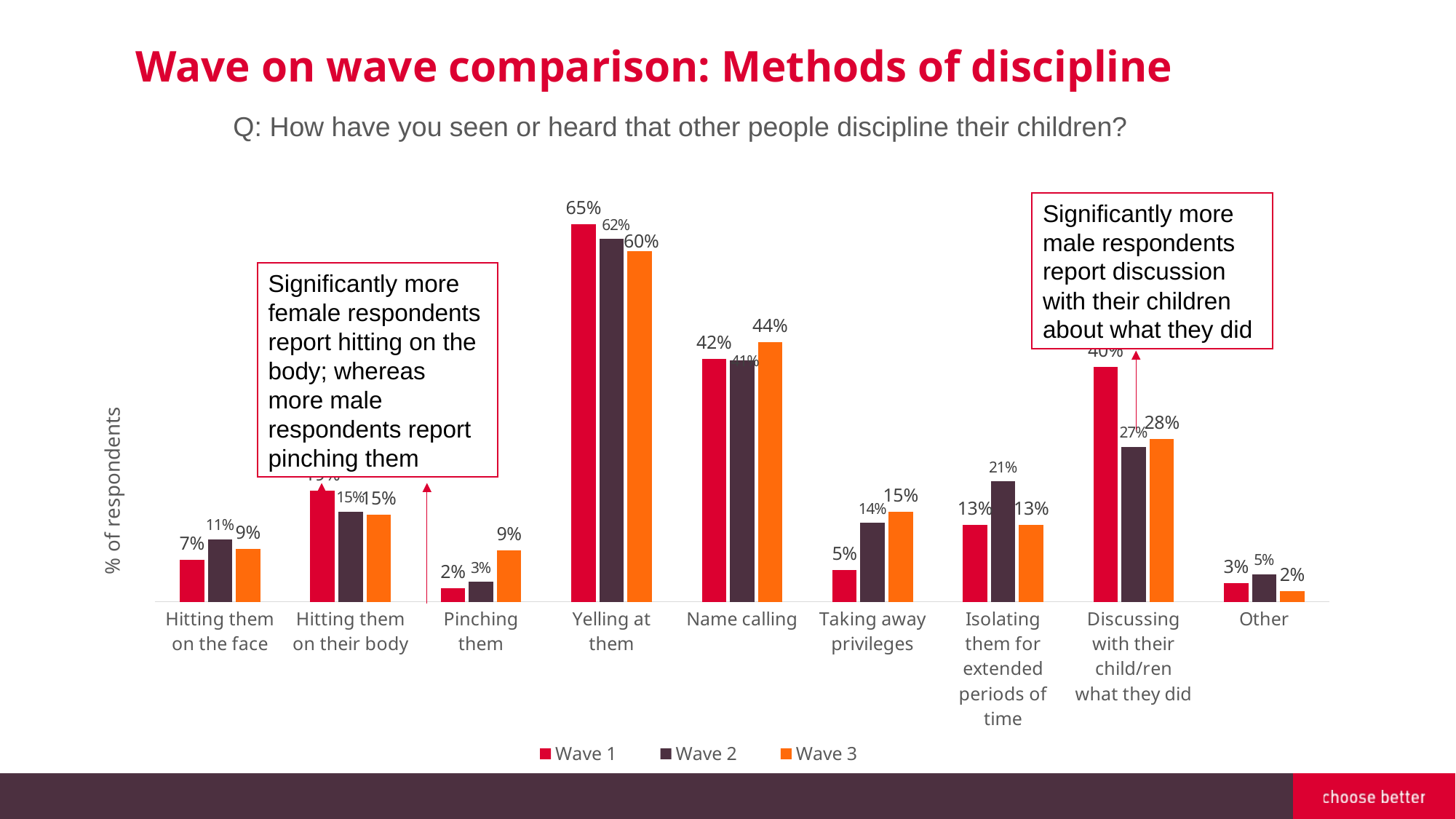
Which category has the highest Wave 1 value? Yelling at them For Wave 2, which is larger: 'Taking away privileges' or 'Hitting them on the face'? Taking away privileges What is the Wave 3 value for 'Pinching them'? 9% What kind of chart is shown on the slide? Bar chart What is the Wave 2 value for 'Isolating them for extended periods of time'? 21% Do the values for 'Yelling at them' rise or fall from Wave 1 to Wave 3? Fall What is the difference between the Wave 1 and Wave 3 values for 'Yelling at them'? 5 percentage points How many discipline method categories are shown on the x axis? 9 How many series does the legend list? 3 What is the Wave 1 value for 'Yelling at them'? 65% What is the Wave 3 value for 'Name calling'? 44% Which category has the lowest Wave 3 value? Other